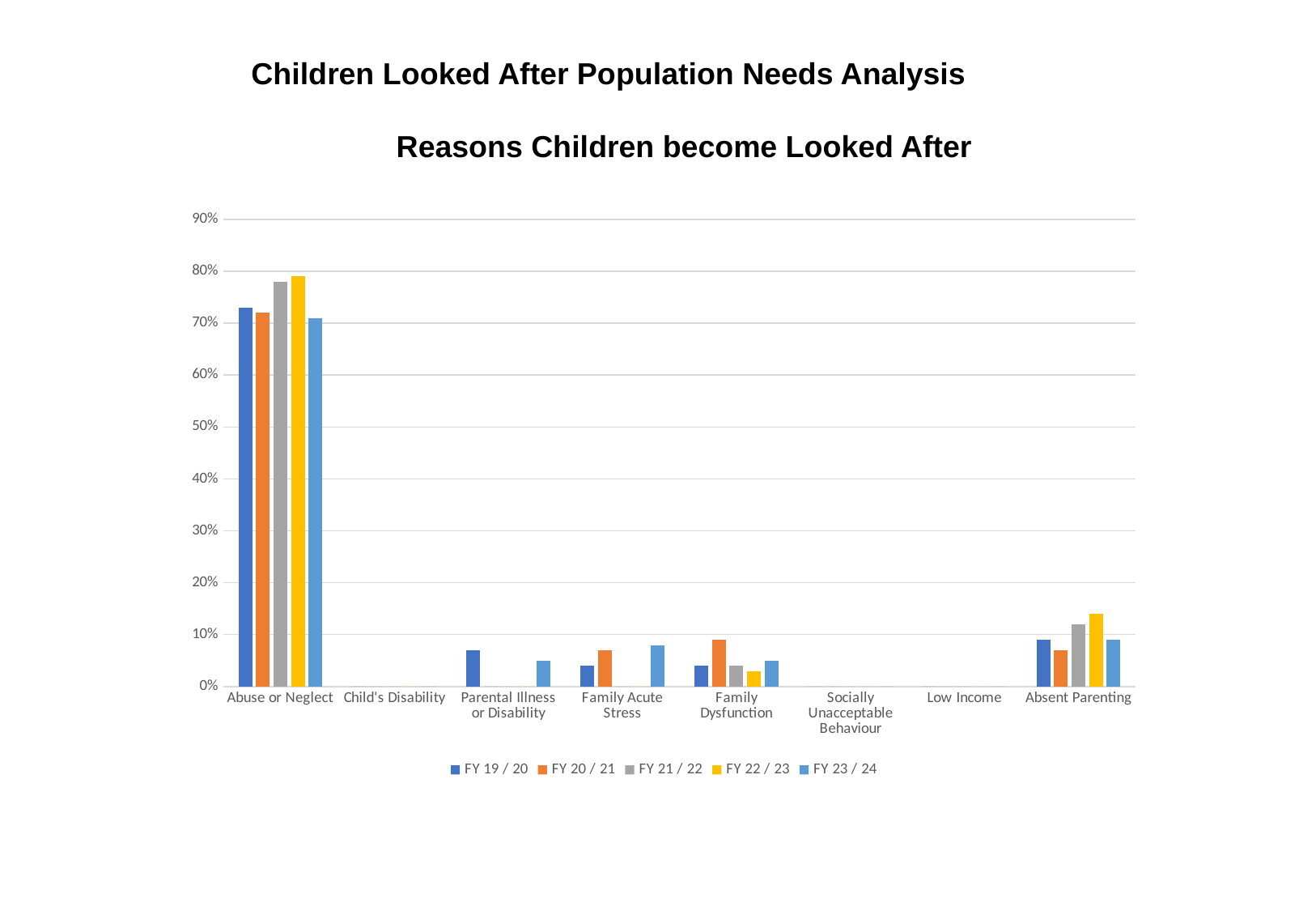
Is the value for Parental Illness or Disability in FY 19 / 20 greater or less than 10%? less Is the value for Absent Parenting in FY 22 / 23 greater or less than 10%? greater For Abuse or Neglect, which is larger: the FY 21 / 22 value or the FY 19 / 20 value? FY 21 / 22 How many categories are shown on the x axis of the chart? 8 Is the value for Abuse or Neglect in FY 22 / 23 greater or less than 70%? greater What is the title of the chart? Reasons Children become Looked After Which series has the highest value for Absent Parenting? FY 22 / 23 Which series has the lowest value for Family Dysfunction? FY 22 / 23 Which series has the highest value for Family Dysfunction? FY 20 / 21 What kind of chart is shown on the slide? bar chart How many series does the legend list? 5 Which category has the highest values across all series? Abuse or Neglect